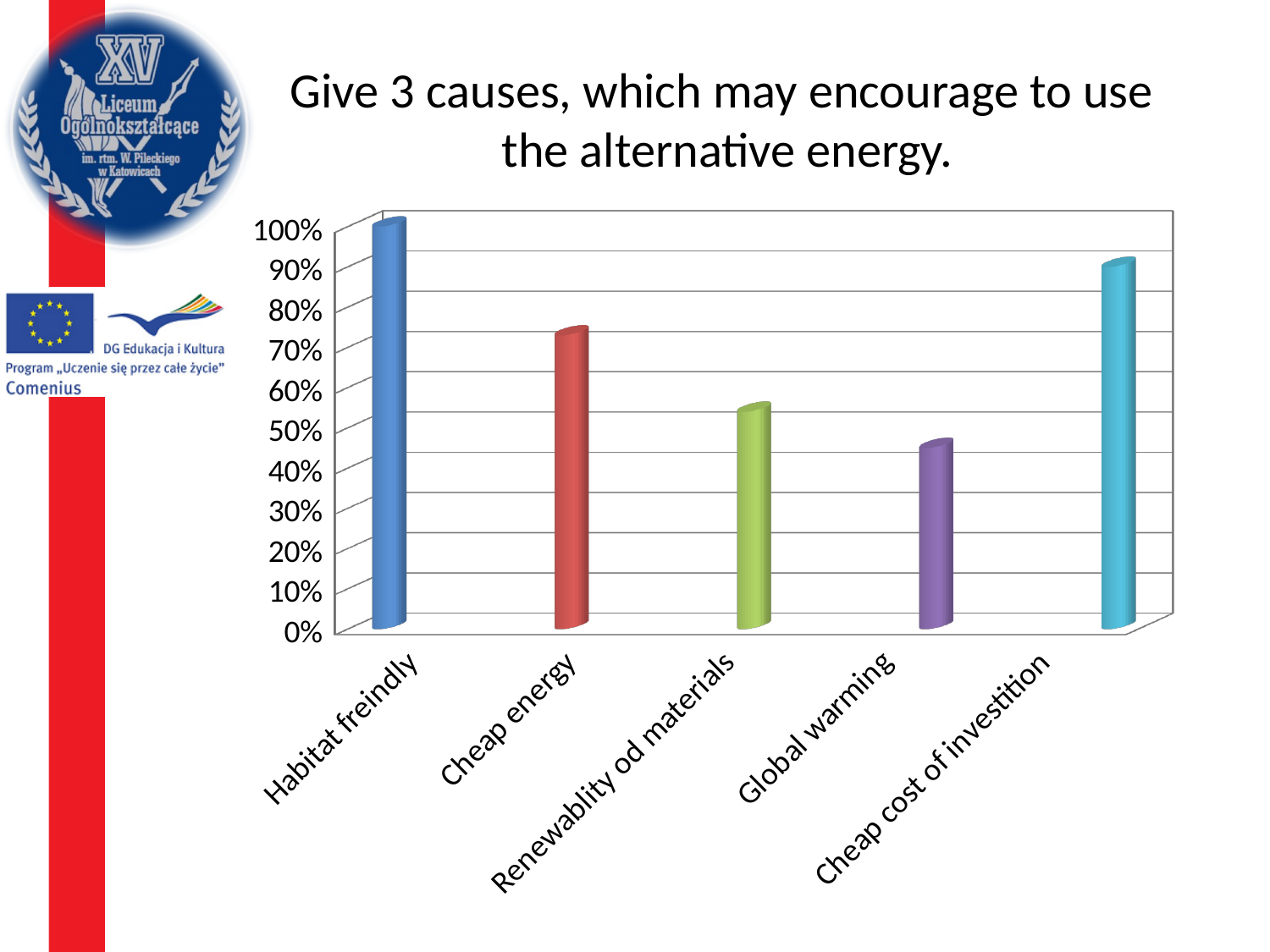
Is the value for Cheap cost of investition greater or less than 80%? greater Is the value for Cheap energy greater or less than 80%? less Which is larger, the value for Cheap cost of investition or the value for Cheap energy? Cheap cost of investition Is the value for Cheap energy greater or less than 60%? greater How many categories are shown on the x axis of the chart? 5 Which category has the highest value in the chart? Habitat freindly Which category has the lowest value in the chart? Global warming Which is larger, the value for Cheap energy or the value for Renewablity od materials? Cheap energy What kind of chart is shown on the slide? bar chart What is the title shown above the chart? Give 3 causes, which may encourage to use the alternative energy.